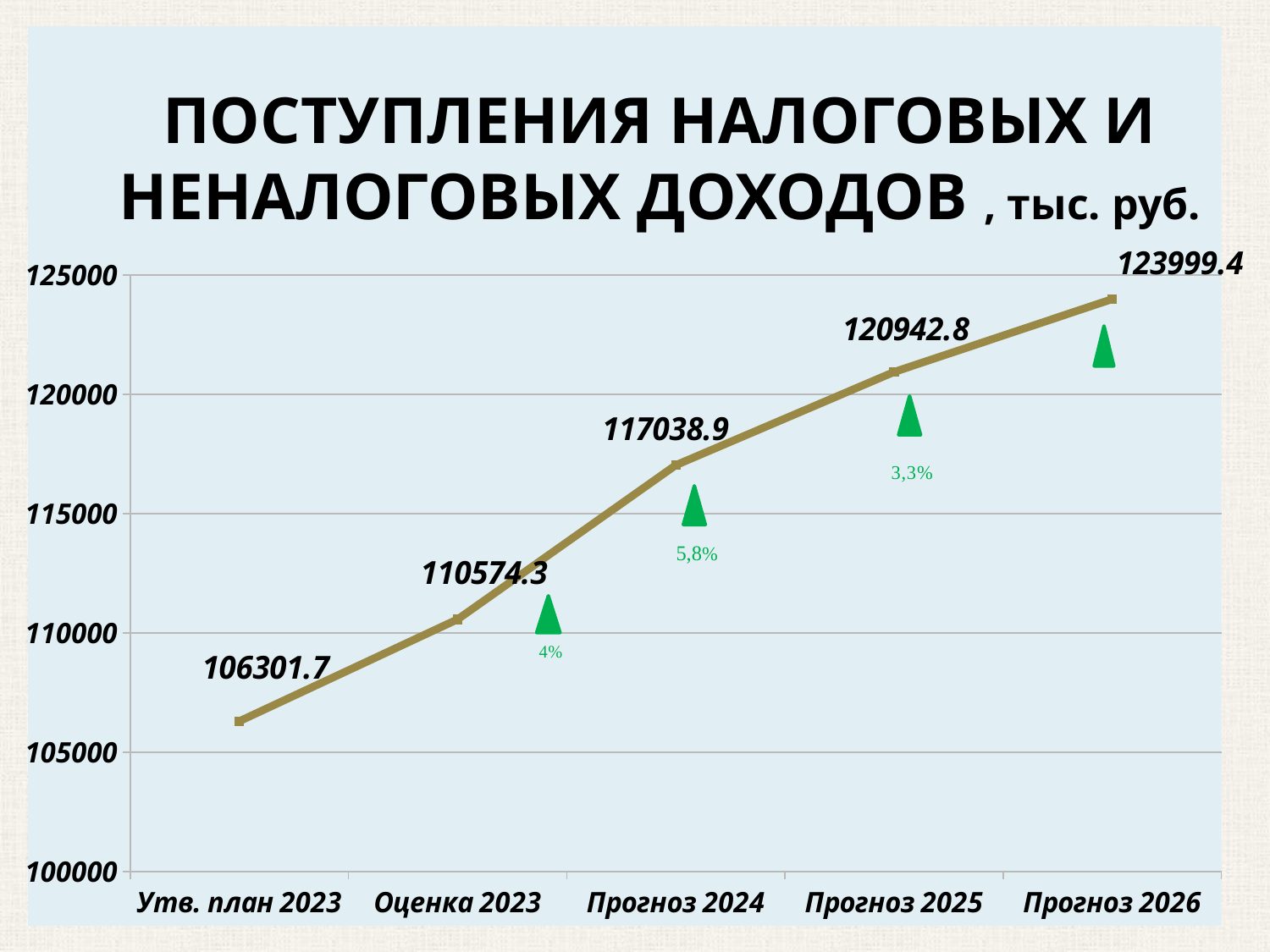
What is the difference between the values for Оценка 2023 and Утв. план 2023? 4272.6 What is the value for Прогноз 2026? 123999.4 What kind of chart is shown on the slide? line chart What is the difference between the values for Прогноз 2026 and Прогноз 2025? 3056.6 Which is larger, the value for Прогноз 2025 or the value for Прогноз 2024? Прогноз 2025 Do the values rise or fall from Утв. план 2023 to Прогноз 2026? rise Is the value for Оценка 2023 greater or less than 115000? less What is the value for Прогноз 2024? 117038.9 What is the value for Утв. план 2023? 106301.7 Which category has the lowest value? Утв. план 2023 How many data points are plotted on the chart? 5 Which category has the highest value? Прогноз 2026